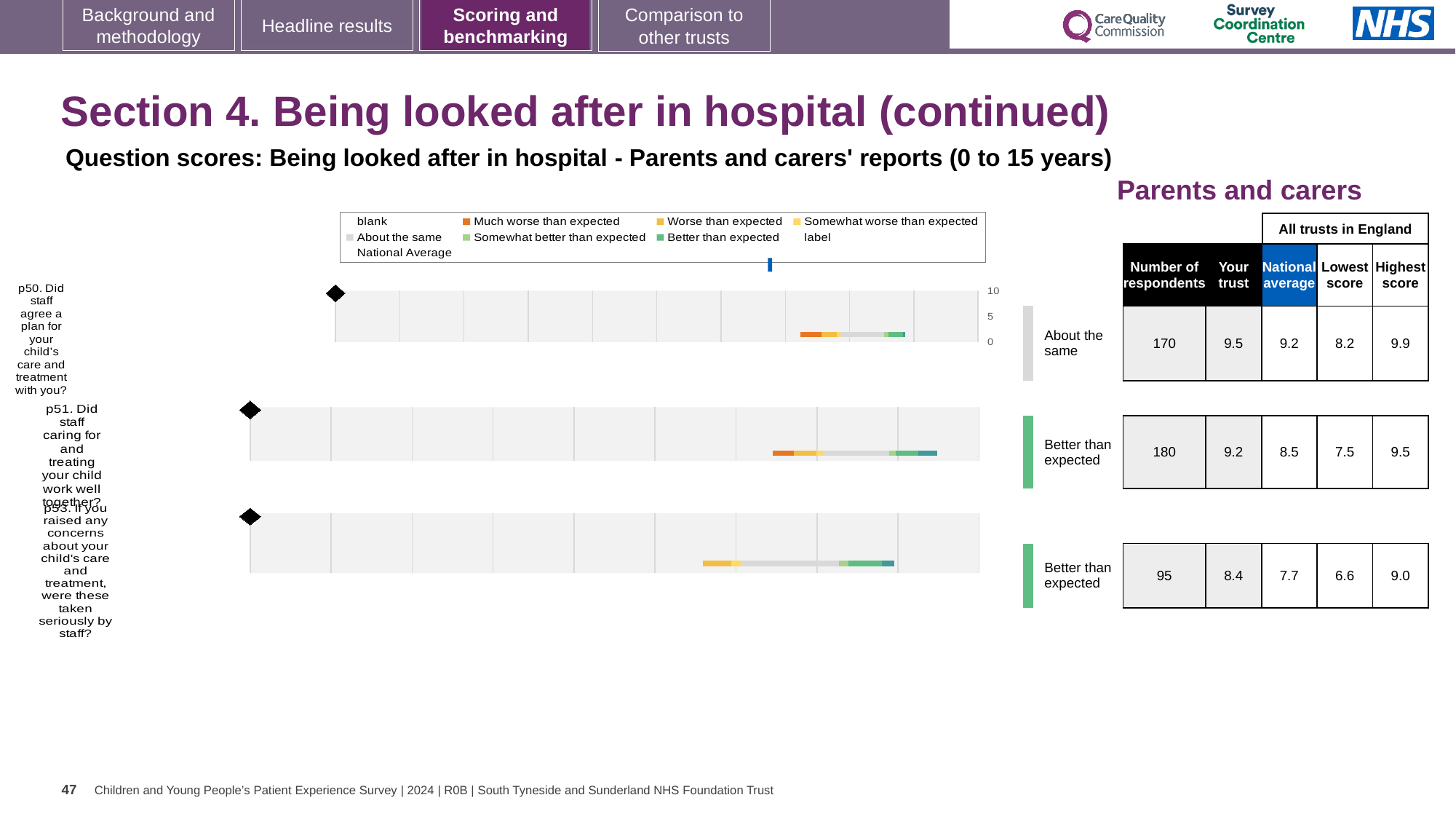
In the chart for p50, what is the highest score among all trusts in England? 9.9 What benchmark category is shown next to the chart for p51? Better than expected Which is larger: the 'Your trust' score for p50 or for p51? p50 In the chart for p50 (Did staff agree a plan for your child's care and treatment with you?), how many respondents are shown in the table? 170 In the chart for p51, what is the lowest score among all trusts in England? 7.5 In the chart for p53, what is the difference between the 'Your trust' score and the national average? 0.7 What kind of chart is used for each question on the slide? Bar chart How many question charts are shown on the slide? 3 Across the three question charts on the slide, which question has the lowest number of respondents? p53 Across the three question charts on the slide, which question has the highest 'Your trust' score? p50 In the chart for p53 (If you raised any concerns about your child's care and treatment, were these taken seriously by staff?), what is the national average score? 7.7 In the chart for p51 (Did staff caring for and treating your child work well together?), what is the 'Your trust' score? 9.2